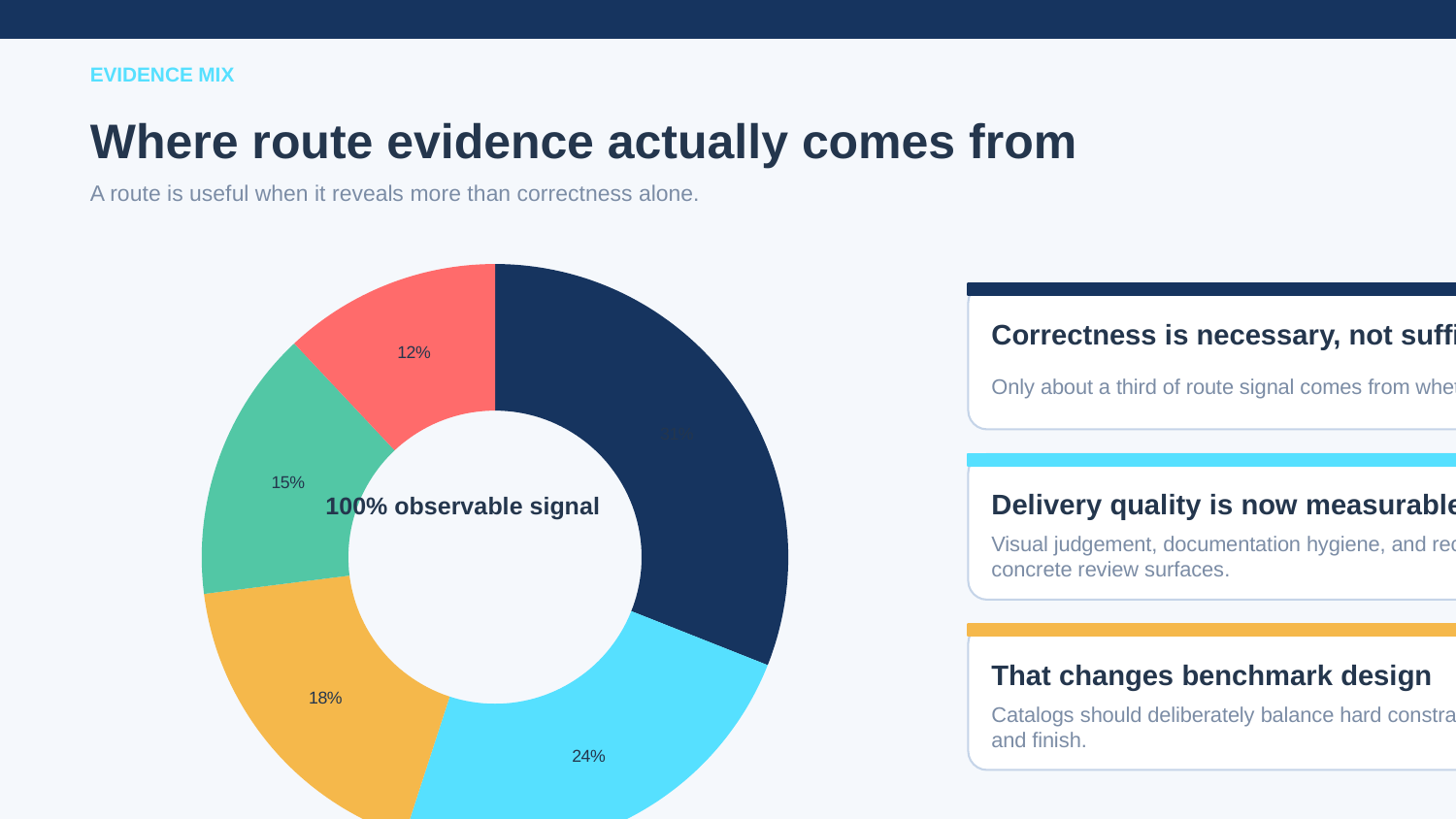
What is the difference between the light blue slice and the yellow slice in the donut chart? 6% How many slices does the donut chart have? 5 Which slice of the donut chart is the smallest? the red slice (12%) What percentage is shown on the red slice of the donut chart? 12% What is the difference between the light blue slice and the red slice in the donut chart? 12% Which slice of the donut chart is the largest? the dark navy slice What text is printed in the centre of the donut chart? 100% observable signal What percentage is shown on the light blue (cyan) slice of the donut chart? 24% What percentage is shown on the green slice of the donut chart? 15% What kind of chart is shown on the slide? pie chart (donut) What percentage is shown on the yellow slice of the donut chart? 18% Which is larger in the donut chart, the green slice or the red slice? the green slice